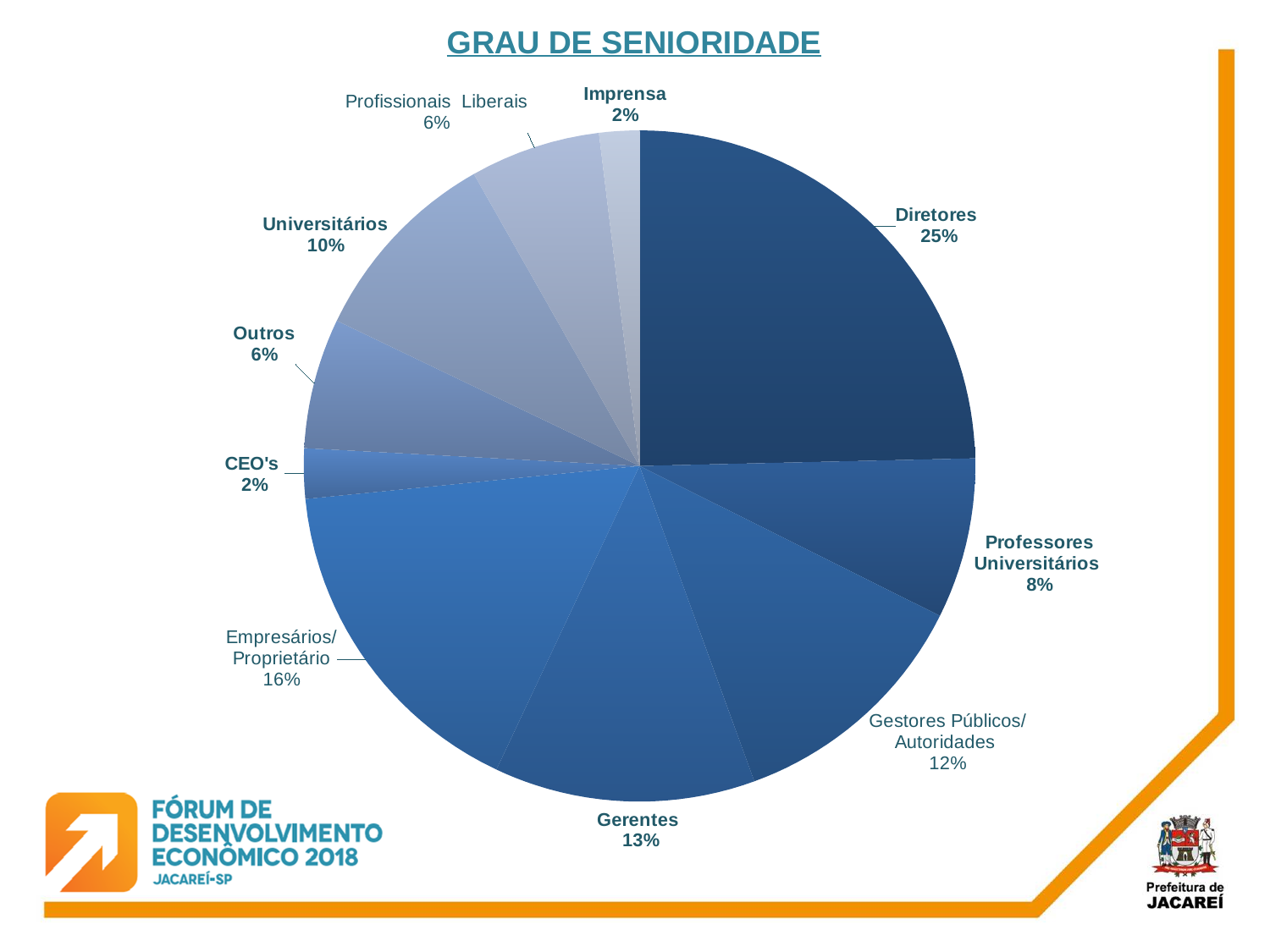
What is the value for Professores Universitários? 8% What is the value for Universitários? 10% What is the chart's title? GRAU DE SENIORIDADE Which category has the largest slice of the pie? Diretores What type of chart is shown on the slide? pie chart What percentage is shown for Empresários/Proprietário? 16% What is the difference in percentage points between Diretores and Gerentes? 12 What percentage is shown for Gestores Públicos/Autoridades? 12% Which is larger, the share for Gerentes or the share for Gestores Públicos/Autoridades? Gerentes What is the combined share of Outros and Profissionais Liberais? 12% How many categories are shown in the pie chart? 10 What share of the pie does Diretores represent? 25%